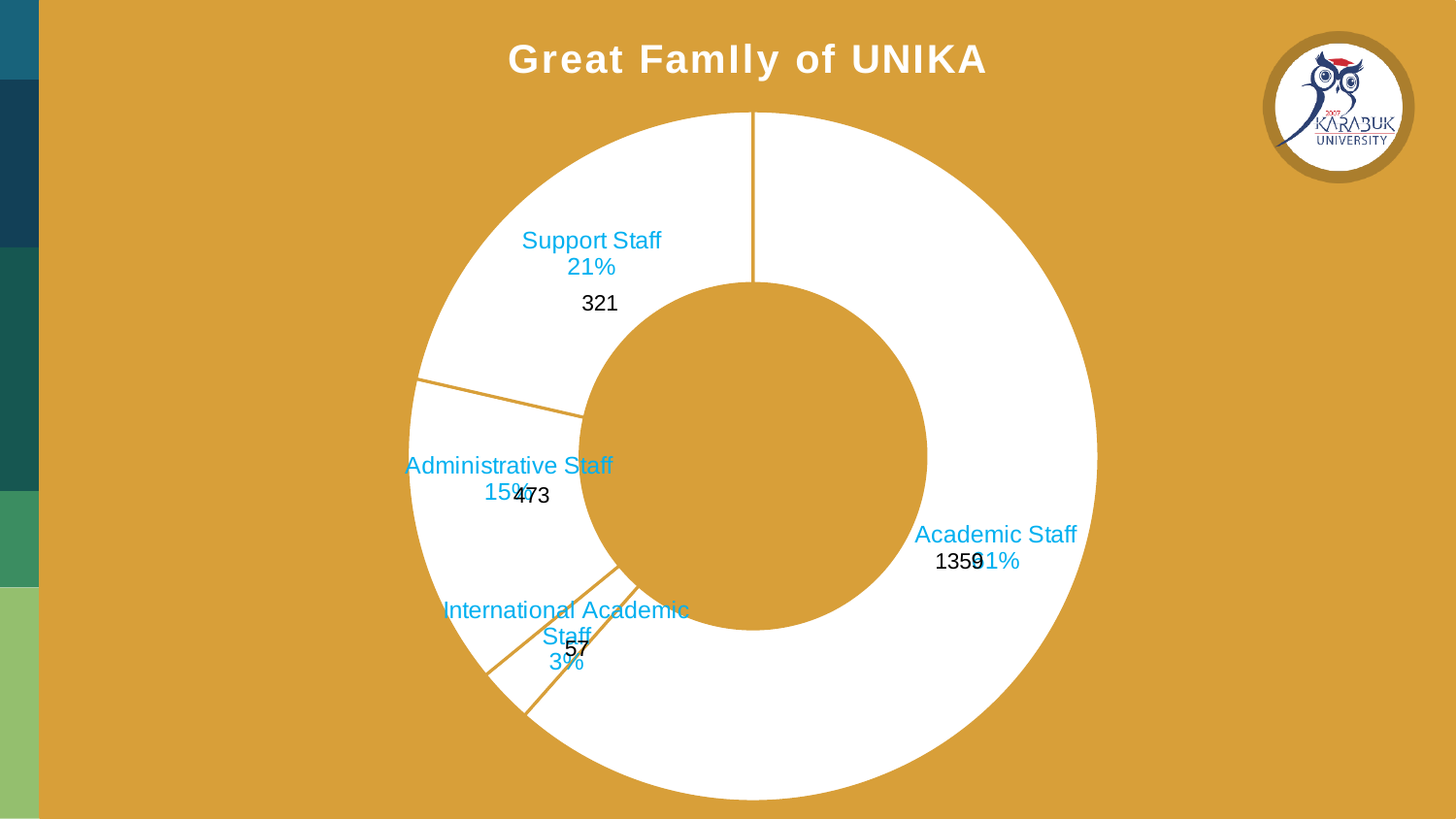
What kind of chart is shown on the slide? Doughnut (pie) chart What percentage share is shown for Support Staff? 21% By how many percentage points does the Academic Staff share exceed the Support Staff share? 40 percentage points How many categories does the chart show? 4 Which has the larger percentage share, Support Staff or Administrative Staff? Support Staff What number is printed for International Academic Staff? 57 Which category has the smallest share of the chart? International Academic Staff What percentage share is shown for Academic Staff? 61% What is the title of the chart? Great FamIly of UNIKA What percentage share is shown for International Academic Staff? 3% Which category has the largest share of the chart? Academic Staff What percentage share is shown for Administrative Staff? 15%